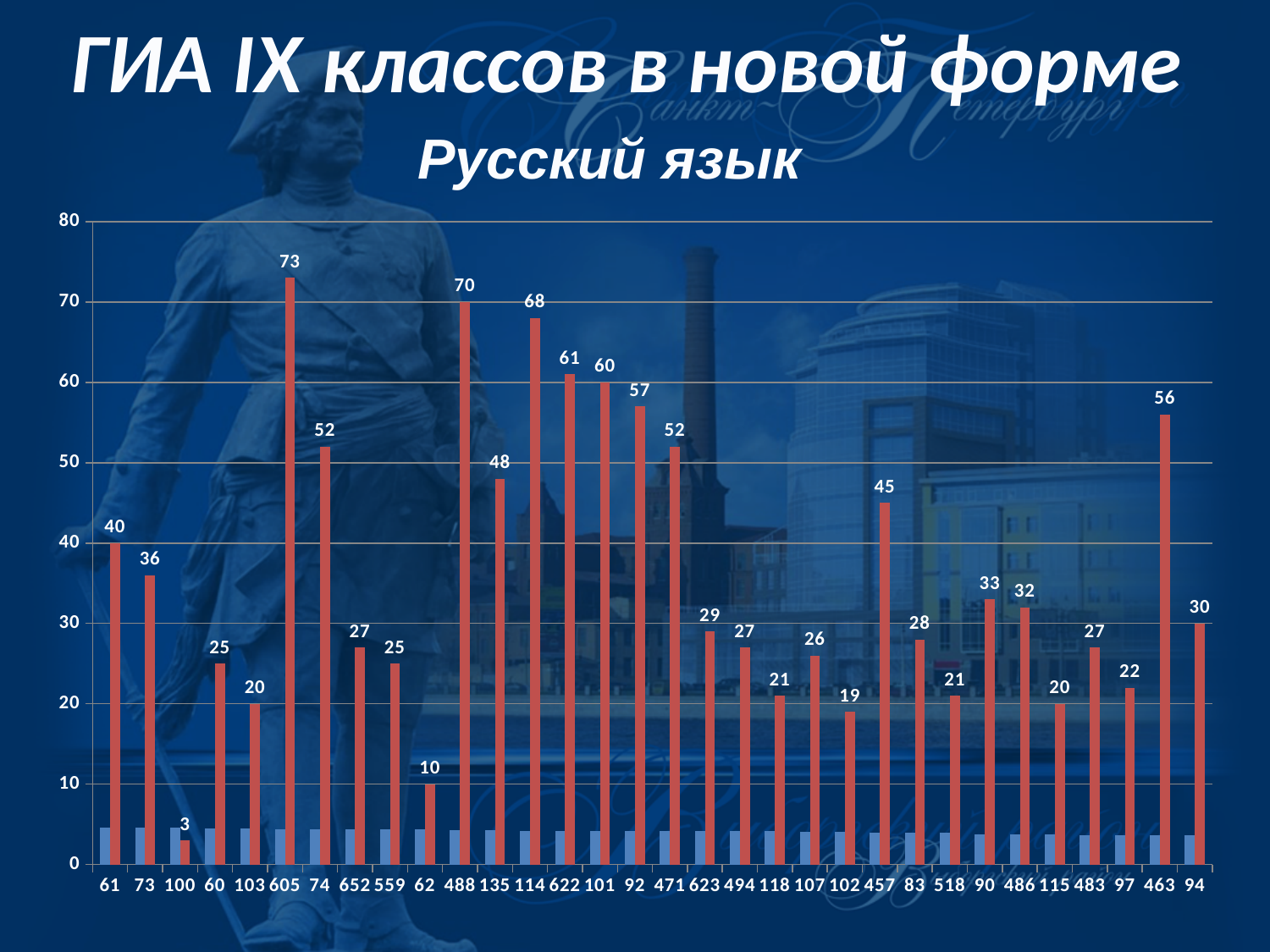
What is the value of the red bar for category 62? 10 What is the value of the red bar for category 605? 73 Which category has the highest red bar? 605 Is the value of the blue bar for category 61 greater or less than 10? less What is the value of the red bar for category 488? 70 Which category has the lowest red bar? 100 Which category has a larger red bar value, 114 or 622? 114 What is the difference between the red bar values for categories 605 and 488? 3 What kind of chart is shown on the slide? bar chart What is the value of the red bar for category 463? 56 How many categories are shown on the x axis? 32 What is the difference between the red bar values for categories 457 and 83? 17